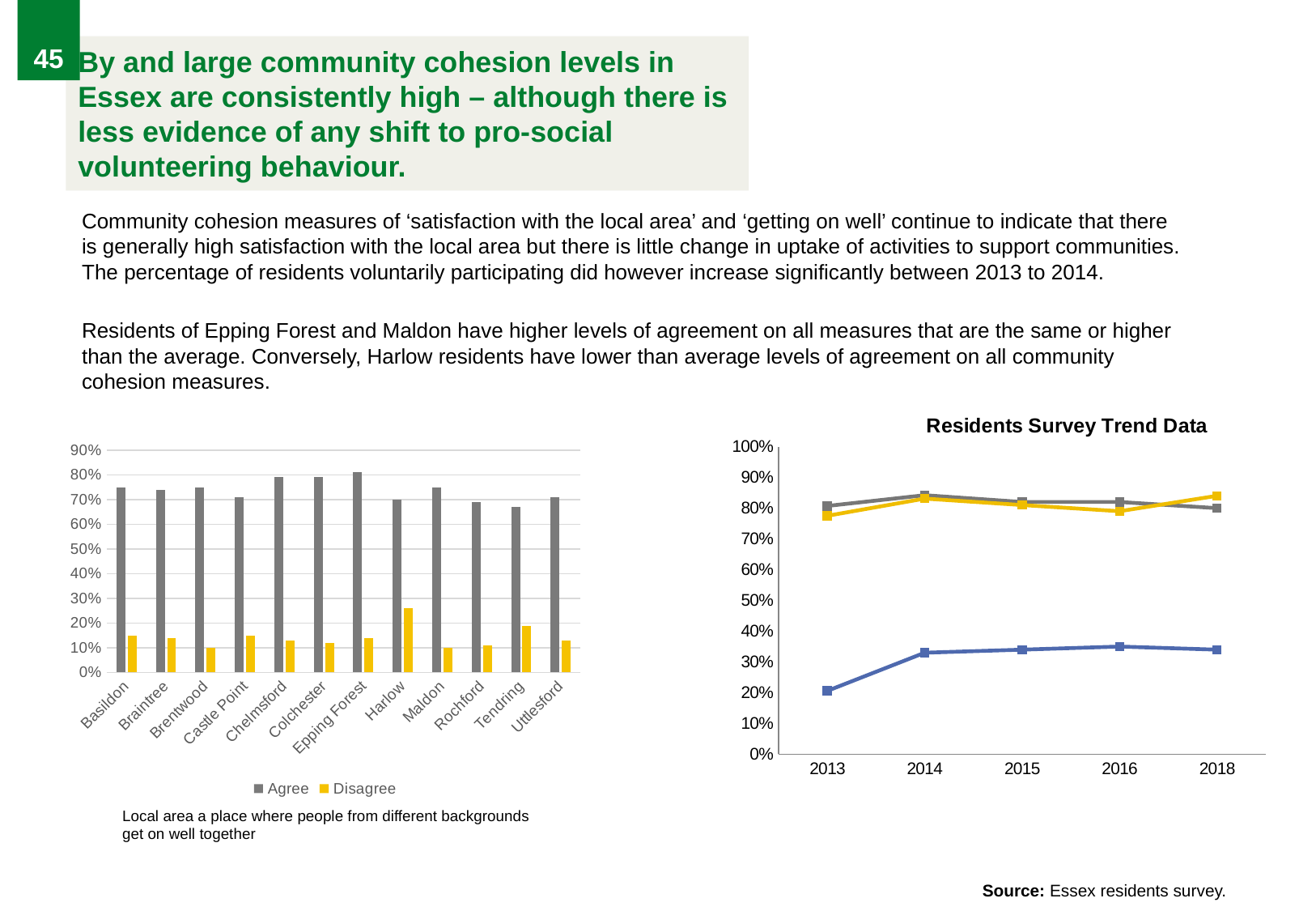
In the bar chart on the left, which district has the highest Disagree value? Harlow What kind of chart is the chart on the left of the slide? bar chart In the bar chart on the left, how many districts are shown on the x axis? 12 In the bar chart on the left, is the Disagree value for Harlow greater or less than 20%? greater In the bar chart on the left, is the Agree value for Tendring greater or less than 70%? less In the bar chart on the left, how many series does the legend list? 2 In the 'Residents Survey Trend Data' chart, is the value of the blue line in 2013 greater or less than 30%? less In the bar chart on the left, which district has the highest Agree value? Epping Forest In the bar chart on the left, which is larger: the Agree value for Chelmsford or the Agree value for Harlow? Chelmsford What kind of chart is the 'Residents Survey Trend Data' chart? line chart In the 'Residents Survey Trend Data' chart, how many years are shown on the x axis? 5 In the 'Residents Survey Trend Data' chart, does the blue line rise or fall between 2013 and 2014? rise